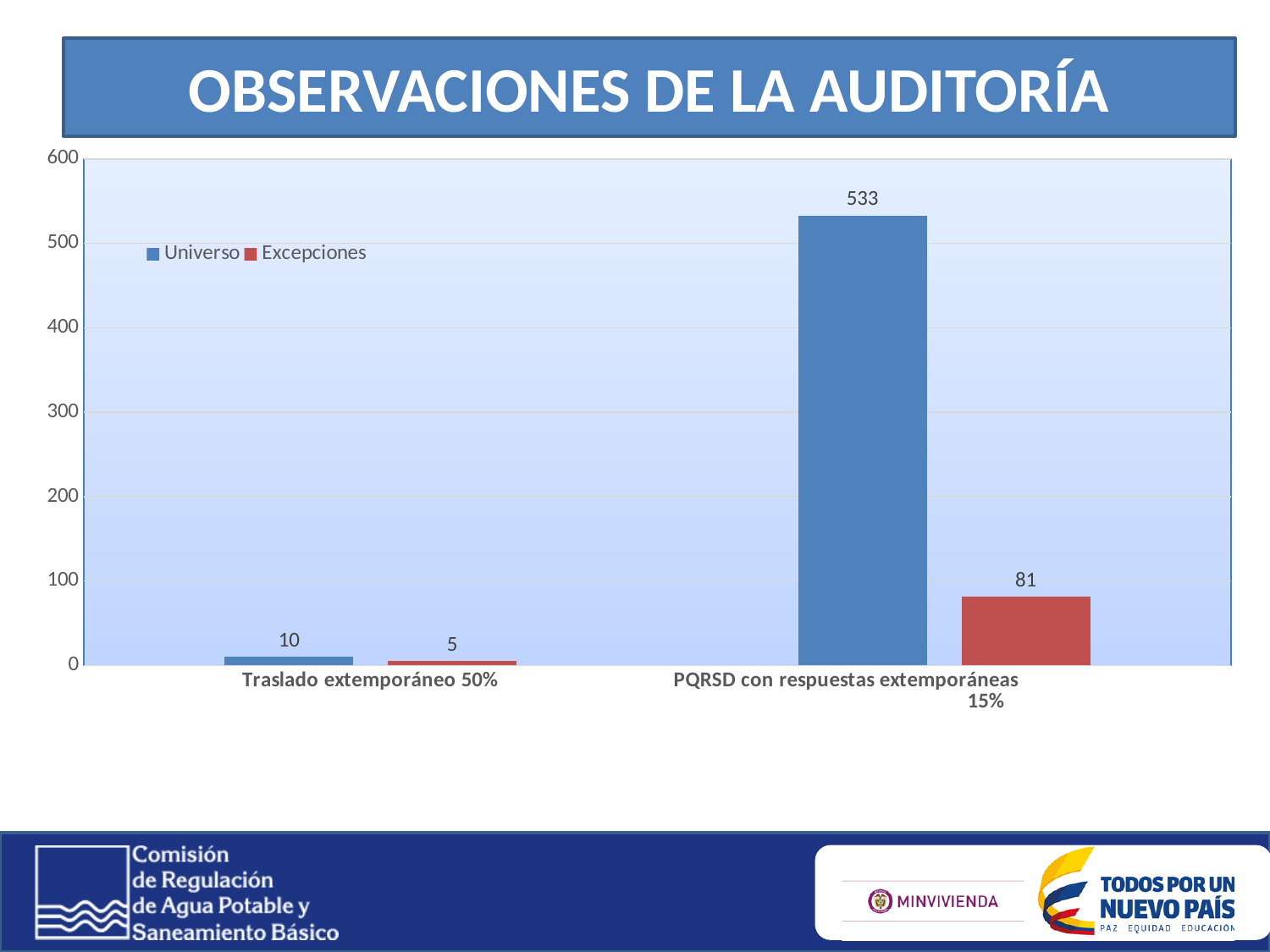
Which category has the lowest Excepciones value? Traslado extemporáneo 50% Which category has the highest Universo value? PQRSD con respuestas extemporáneas 15% What is the difference between the Universo and Excepciones values for 'PQRSD con respuestas extemporáneas 15%'? 452 What is the Universo value for 'Traslado extemporáneo 50%'? 10 What type of chart is shown on the slide? Bar chart Is the Universo value for 'PQRSD con respuestas extemporáneas 15%' greater or less than 500? greater What is the Universo value for 'PQRSD con respuestas extemporáneas 15%'? 533 How many series does the legend list? 2 What is the Excepciones value for 'Traslado extemporáneo 50%'? 5 What is the Excepciones value for 'PQRSD con respuestas extemporáneas 15%'? 81 Which is larger for 'Traslado extemporáneo 50%': Universo or Excepciones? Universo How many categories are shown on the x axis? 2